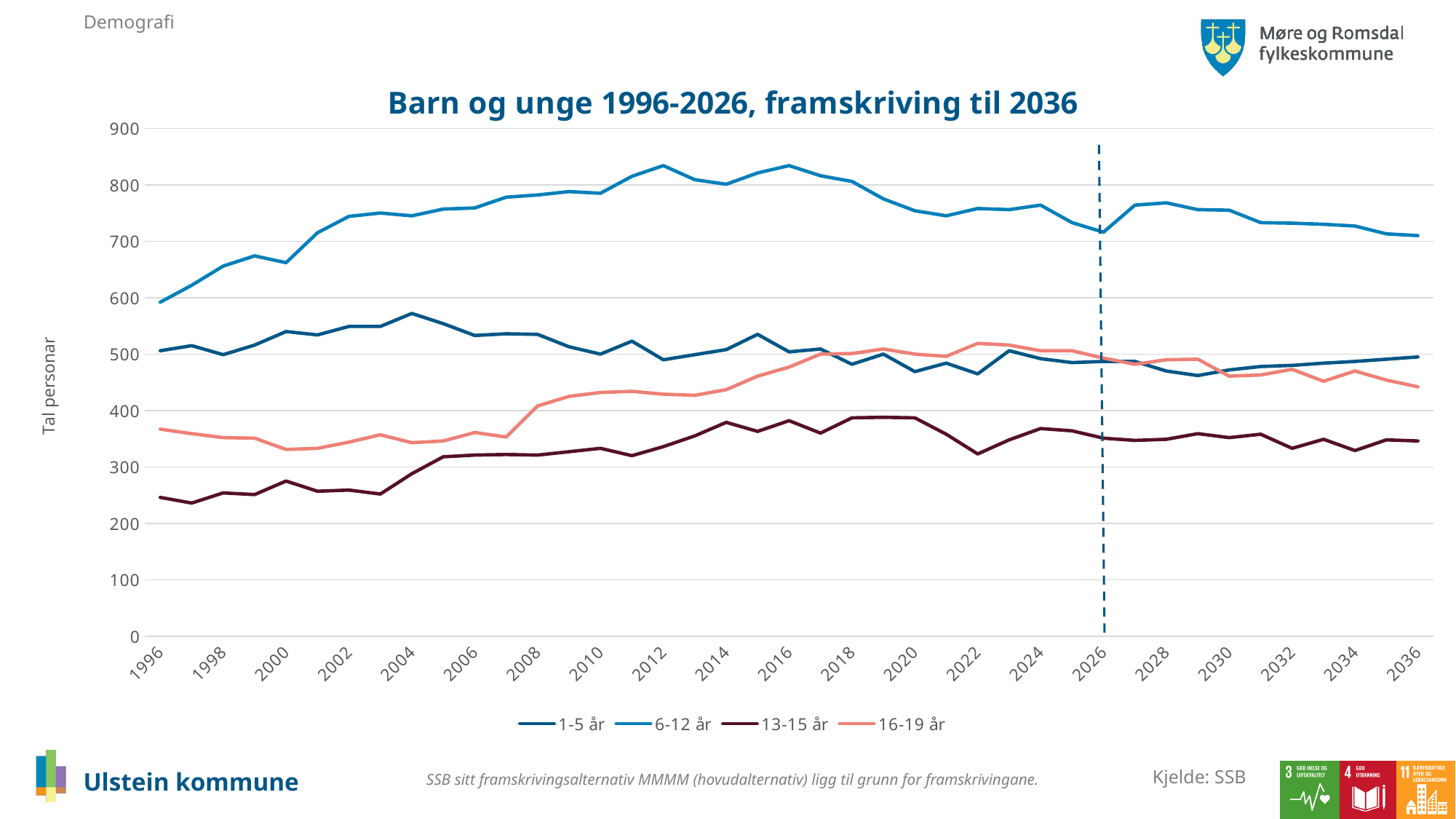
Which series has the lowest value in 1996? 13-15 år In 2010, which series has the larger value, 1-5 år or 16-19 år? 1-5 år Is the value for 13-15 år in 1996 greater or less than 300? less What are the series names listed in the legend? 1-5 år, 6-12 år, 13-15 år, 16-19 år Does the 13-15 år series rise or fall from 1996 to 2018? rise Is the value for 1-5 år in 2004 greater or less than 550? greater What kind of chart is shown on the slide? line chart What is the title of the chart? Barn og unge 1996-2026, framskriving til 2036 Is the value for 6-12 år in 2012 greater or less than 800? greater How many series does the legend list? 4 Which series has the highest values across the whole period? 6-12 år